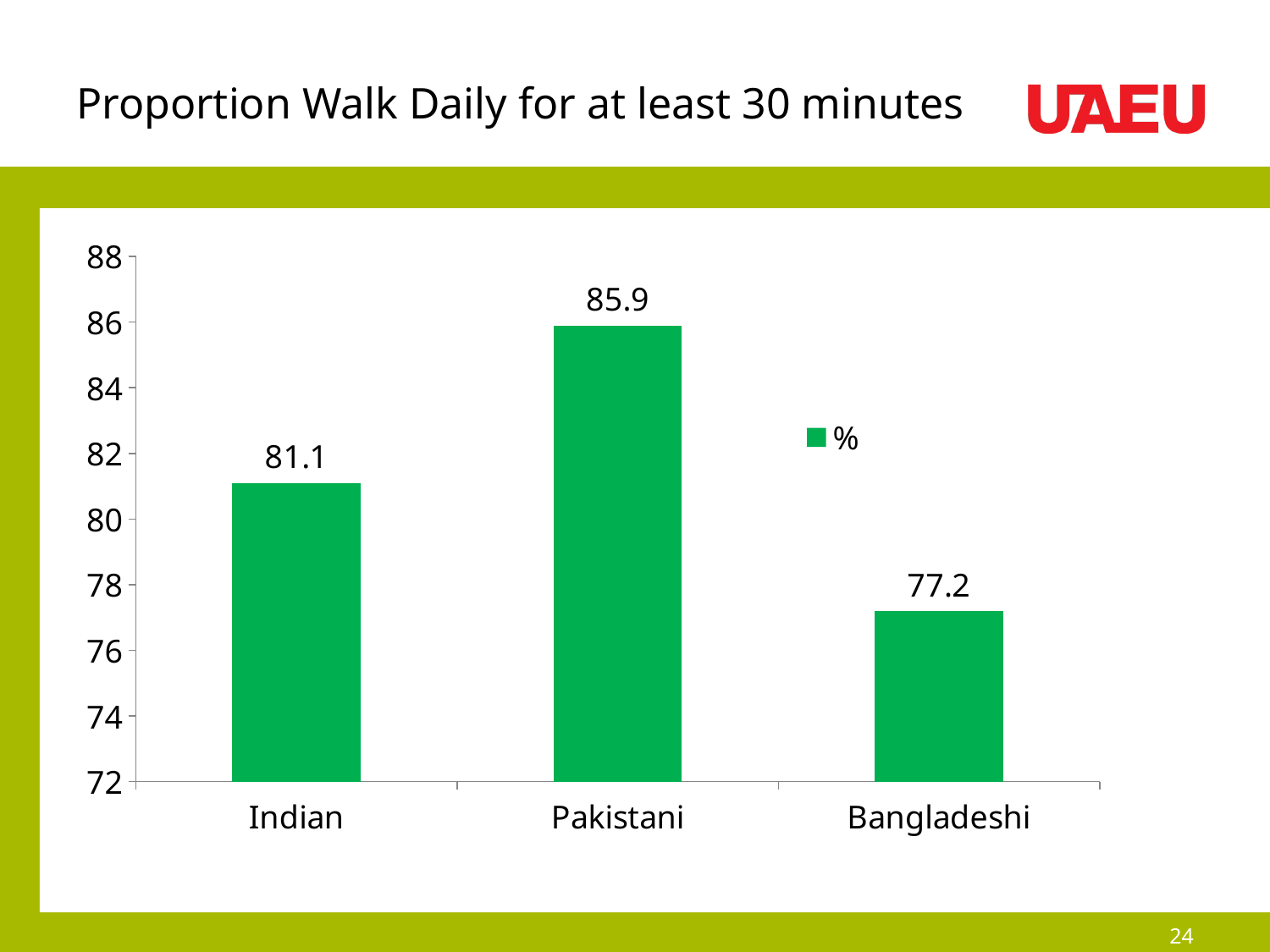
What is the value for Pakistani? 85.9 What is the value for Bangladeshi? 77.2 What kind of chart is shown on the slide? bar chart How many categories are shown on the x axis? 3 Which is larger, the value for Indian or the value for Bangladeshi? Indian Which category has the lowest value? Bangladeshi What is the difference between the values for Pakistani and Indian? 4.8 Is the value for Bangladeshi greater or less than 80? less What is the title of the slide? Proportion Walk Daily for at least 30 minutes What is the value for Indian? 81.1 What is the difference between the values for Indian and Bangladeshi? 3.9 Which category has the highest value? Pakistani